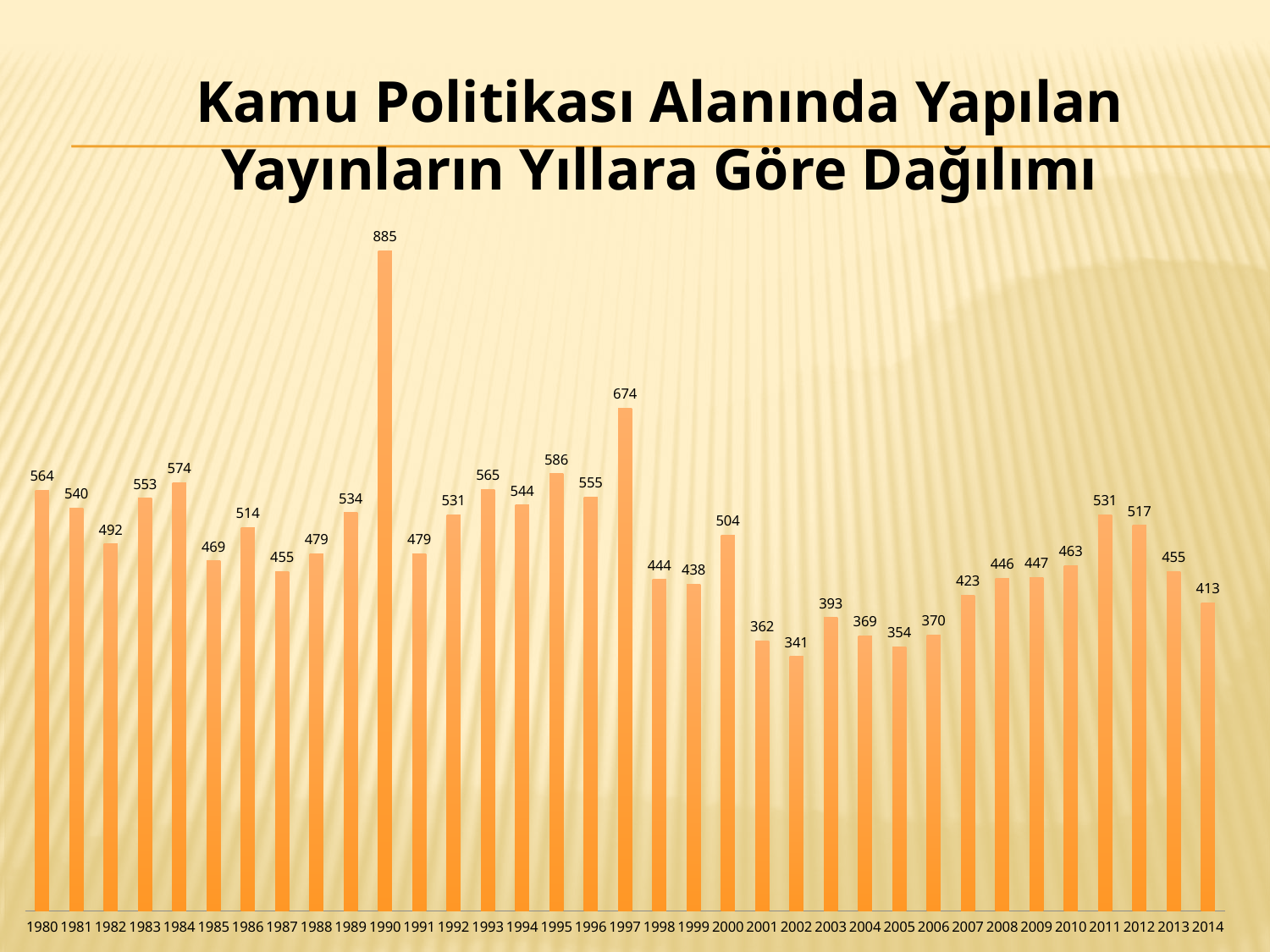
What kind of chart is shown on the slide? Bar chart Which year has the lowest value? 2002 What is the value for 2002? 341 Which year has the highest value? 1990 What is the value for 2014? 413 How many years are shown on the x axis? 35 What is the difference between the values for 2000 and 2001? 142 Which is larger, the value for 1984 or the value for 1995? 1995 What is the difference between the values for 1990 and 1997? 211 What is the value for 1990? 885 What is the value for 1997? 674 What is the title of the chart on the slide? Kamu Politikası Alanında Yapılan Yayınların Yıllara Göre Dağılımı